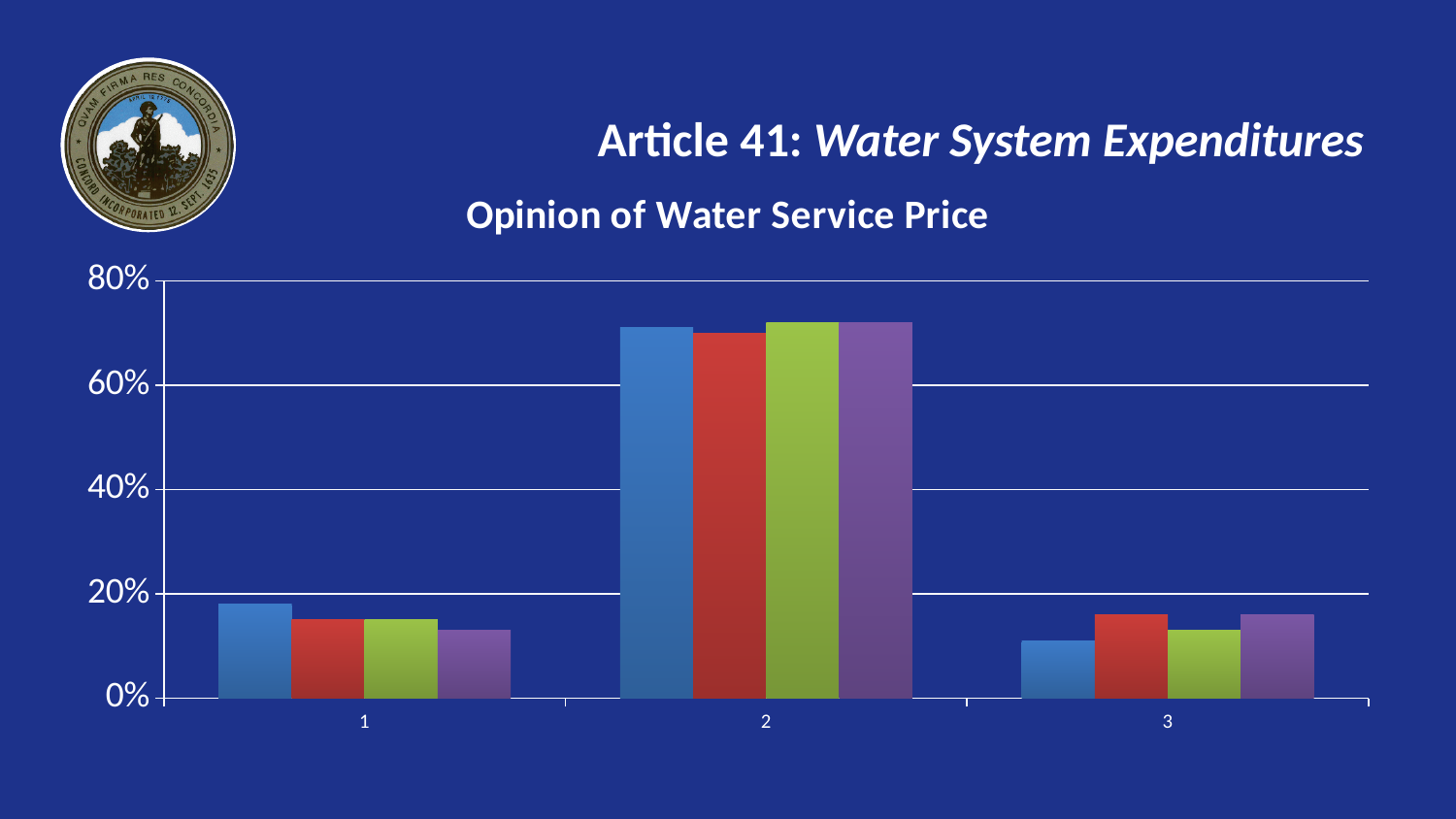
How many categories are shown on the x axis of the chart? 3 Within category 1, which is larger: the blue bar or the purple bar? blue bar Is the value of the purple bar for category 3 greater or less than 20%? less What is the title of the chart? Opinion of Water Service Price Is the value of the green bar for category 2 greater or less than 80%? less What kind of chart is shown on the slide? bar chart Which category has the tallest bars in the chart? 2 Within category 3, which is larger: the blue bar or the red bar? red bar Which is larger: the blue bar for category 1 or the blue bar for category 2? category 2 Is the value of the blue bar for category 1 greater or less than 20%? less How many bars are plotted for each category in the chart? 4